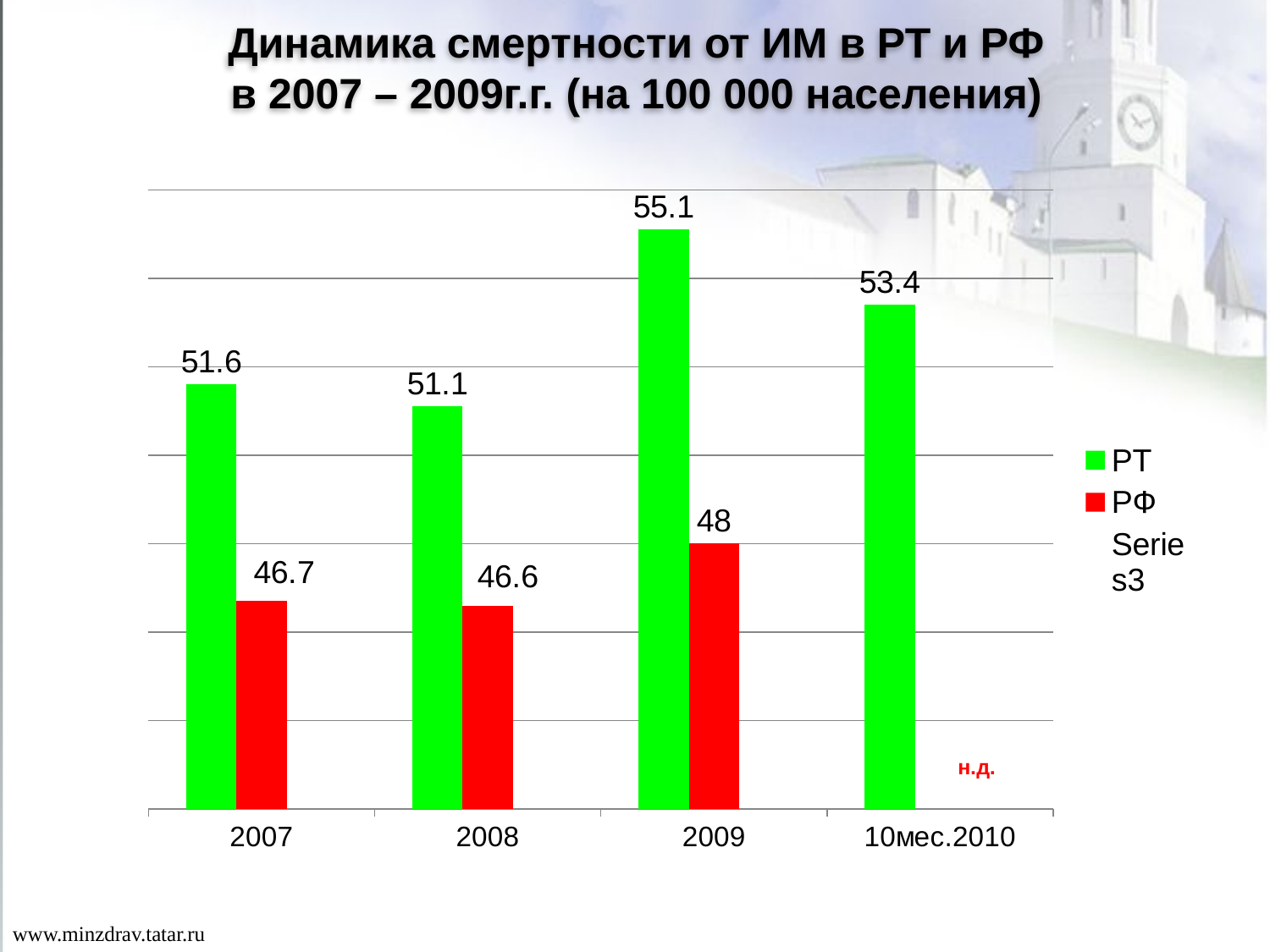
What is the value for РФ in 2009? 48 What is the value for РТ in 2009? 55.1 How many series does the legend list? 3 Which is larger in 2008, the РТ value or the РФ value? РТ What kind of chart is shown on the slide? Bar chart What is the difference between the РТ values in 2009 and 2008? 4 In which category is the РТ value lowest? 2008 In which year is the РТ value highest? 2009 How many categories are shown on the x axis? 4 What is the value for РТ in 10мес.2010? 53.4 What is the value for РФ in 2007? 46.7 What is the difference between the РТ and РФ values in 2009? 7.1